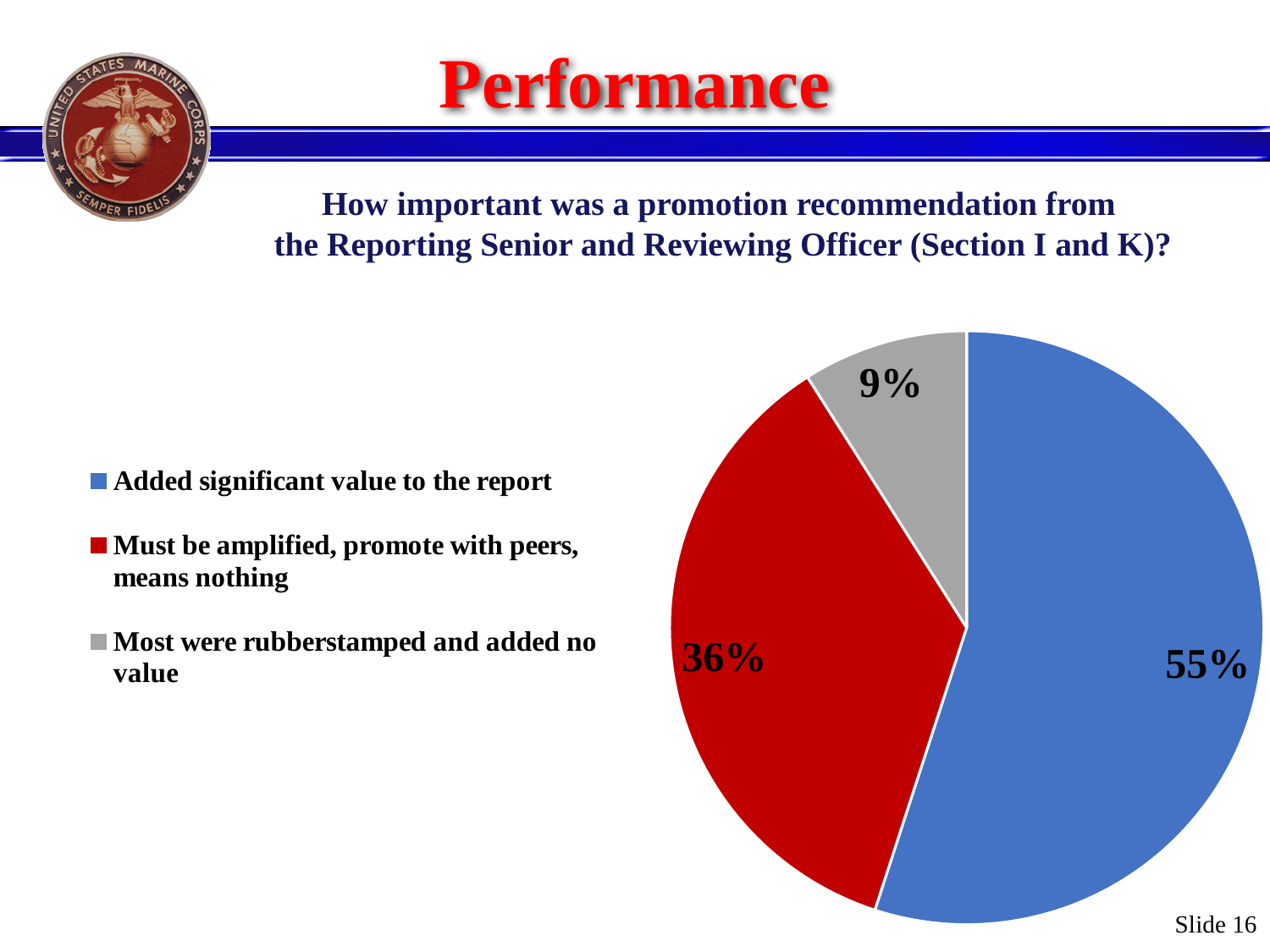
What percentage of respondents said the promotion recommendation added significant value to the report? 55% Which is larger: the share for 'Must be amplified, promote with peers, means nothing' or the share for 'Most were rubberstamped and added no value'? Must be amplified, promote with peers, means nothing How many slices does the pie chart have? 3 Which response has the largest share of the pie? Added significant value to the report How many percentage points separate the 'Must be amplified, promote with peers, means nothing' slice from the 'Most were rubberstamped and added no value' slice? 27 What colour is the slice for 'Most were rubberstamped and added no value'? grey How many entries does the legend list? 3 What percentage of respondents said most were rubberstamped and added no value? 9% What kind of chart is shown on the slide? pie chart Which response has the smallest share of the pie? Most were rubberstamped and added no value How many percentage points larger is the 'Added significant value to the report' slice than the 'Must be amplified, promote with peers, means nothing' slice? 19 What percentage of respondents said the recommendation must be amplified, promote with peers, means nothing? 36%